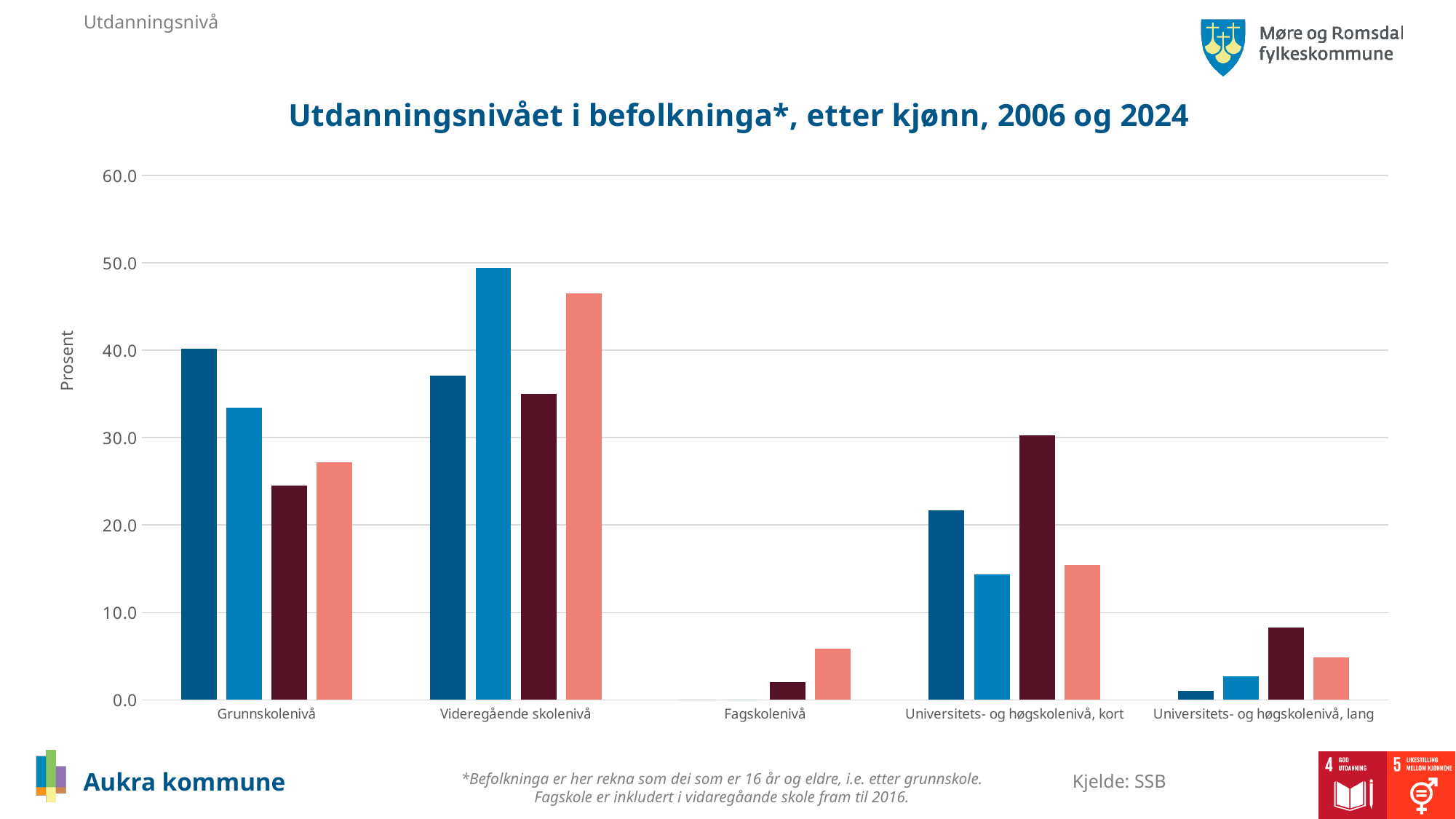
Is the value of the salmon (light red) bar for Fagskolenivå greater or less than 10? less Is the value of the salmon (light red) bar for Videregående skolenivå greater or less than 40? greater Which category contains the shortest bar in the chart? Universitets- og høgskolenivå, lang How many categories are shown on the x axis of the chart? 5 How many bars are plotted for the Fagskolenivå category? 2 What kind of chart is shown on the slide? bar chart Which category contains the tallest bar in the chart? Videregående skolenivå Is the value of the dark blue bar for Universitets- og høgskolenivå, kort greater or less than 20? greater What is the title of the chart? Utdanningsnivået i befolkninga*, etter kjønn, 2006 og 2024 What is the label of the vertical axis? Prosent Which is larger: the dark blue bar for Grunnskolenivå or the dark blue bar for Videregående skolenivå? Grunnskolenivå